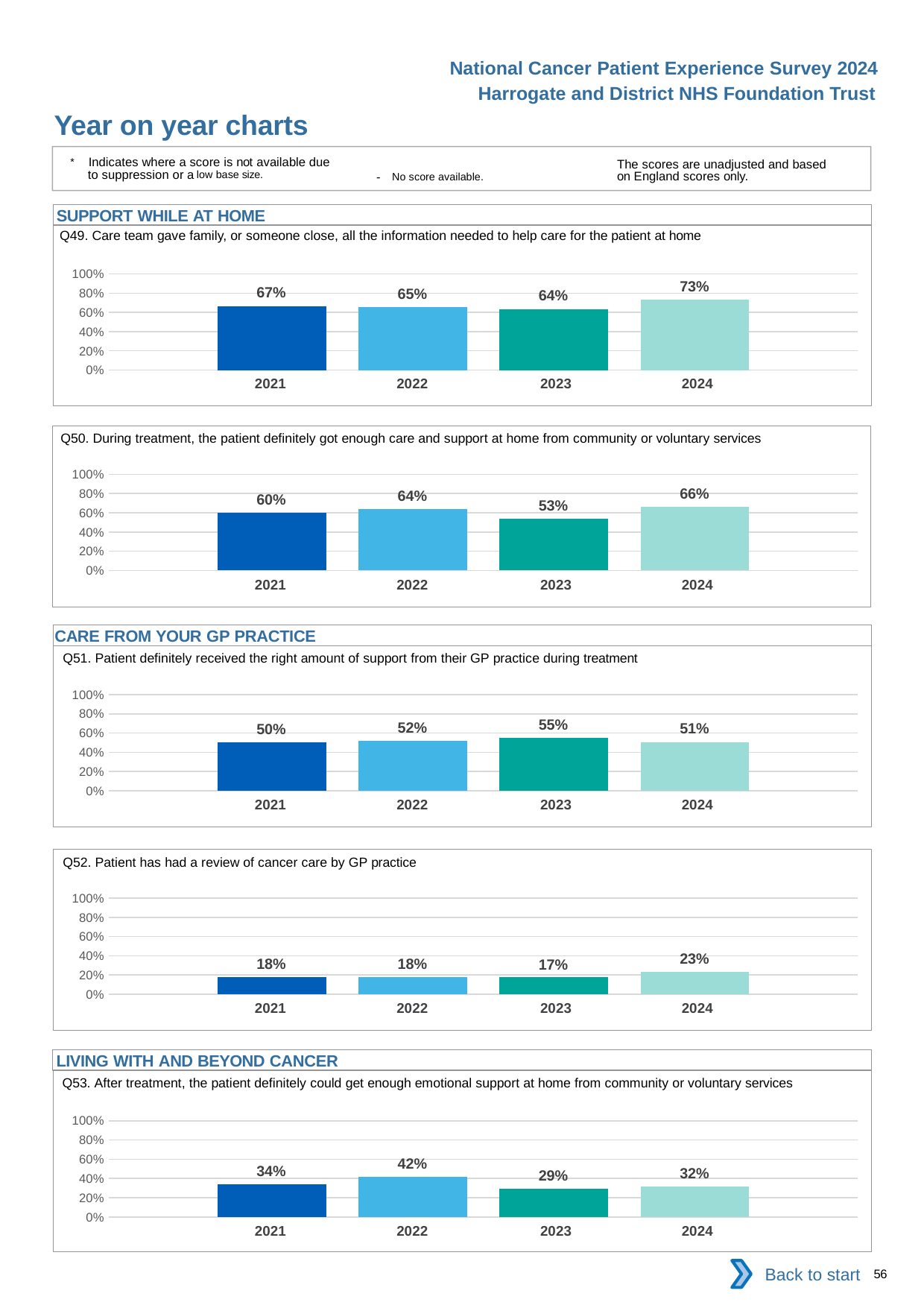
In the Q49 chart, which year has the lowest value? 2023 In the Q53 chart, which year has the highest value? 2022 In the Q50 chart, which year has the highest value? 2024 In the Q52 chart, what is the value for 2024? 23% In the Q50 chart, what is the difference between the 2024 value and the 2023 value? 13% In the Q52 chart, is the value for 2021 greater or less than 40%? less In the Q51 chart, what is the value for 2023? 55% In the Q49 chart, what is the value for 2024? 73% What type of chart is the Q52 chart? bar chart In the Q53 chart, what is the difference between the 2022 value and the 2021 value? 8% How many years are plotted in the Q49 chart? 4 In the Q51 chart, is the value for 2021 larger or smaller than the value for 2023? smaller